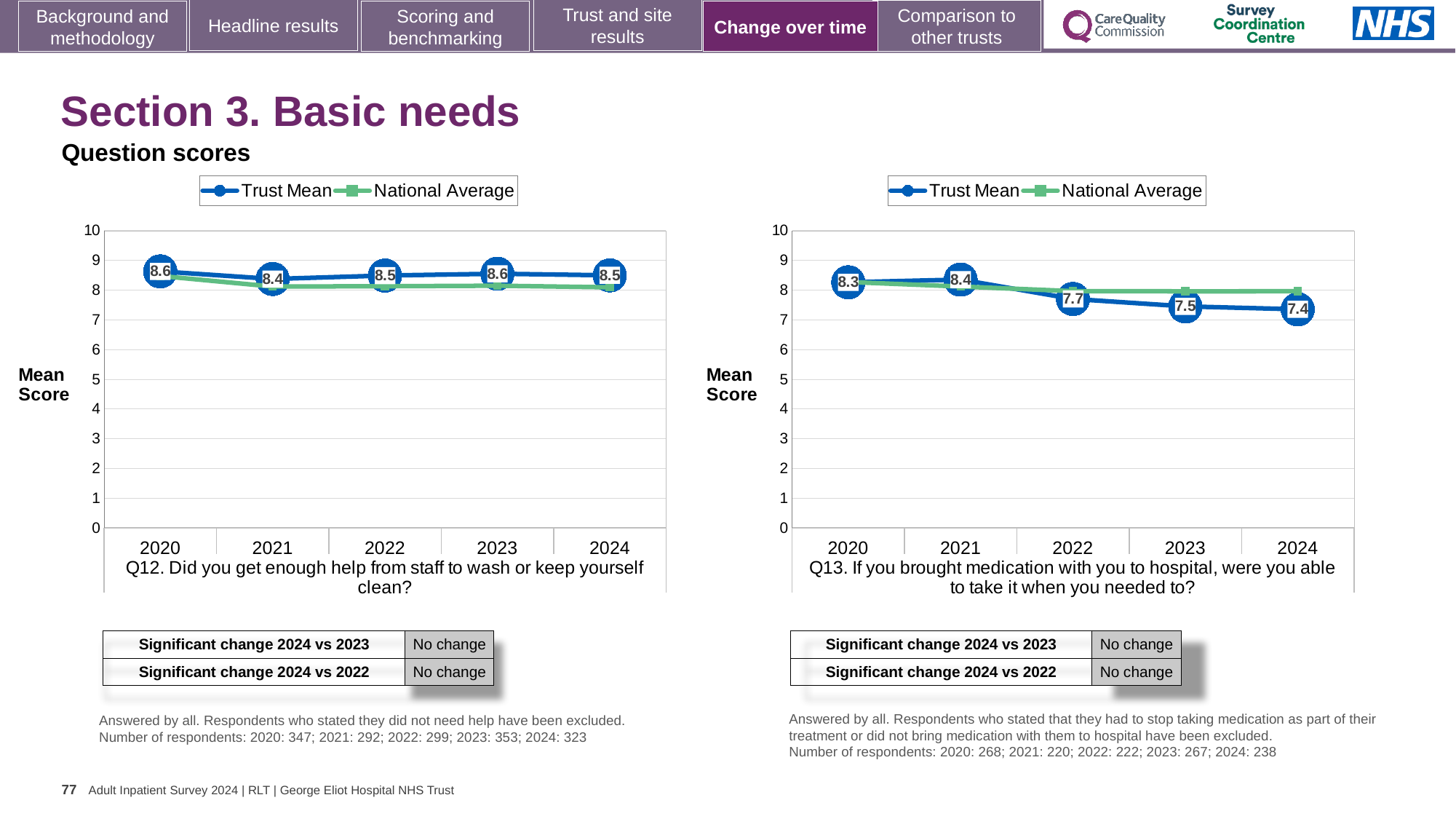
In the Q12 chart (left), what is the Trust Mean for 2024? 8.5 In the Q12 chart (left), what is the Trust Mean for 2020? 8.6 How many series does the legend of the Q12 chart (left) list? 2 In the Q13 chart (right), which year has the highest Trust Mean? 2021 In the Q12 chart (left), what is the difference between the Trust Mean for 2023 and 2021? 0.2 What type of chart is the Q13 chart (right)? line chart In the Q12 chart (left), which year has the lowest Trust Mean? 2021 In the Q13 chart (right), what is the difference between the Trust Mean for 2020 and 2024? 0.9 In the Q13 chart (right), which year has the lowest Trust Mean? 2024 In the Q13 chart (right), what is the Trust Mean for 2022? 7.7 In the Q13 chart (right), is the National Average for 2024 greater or less than 7? greater In the Q13 chart (right), does the Trust Mean rise or fall from 2021 to 2024? fall